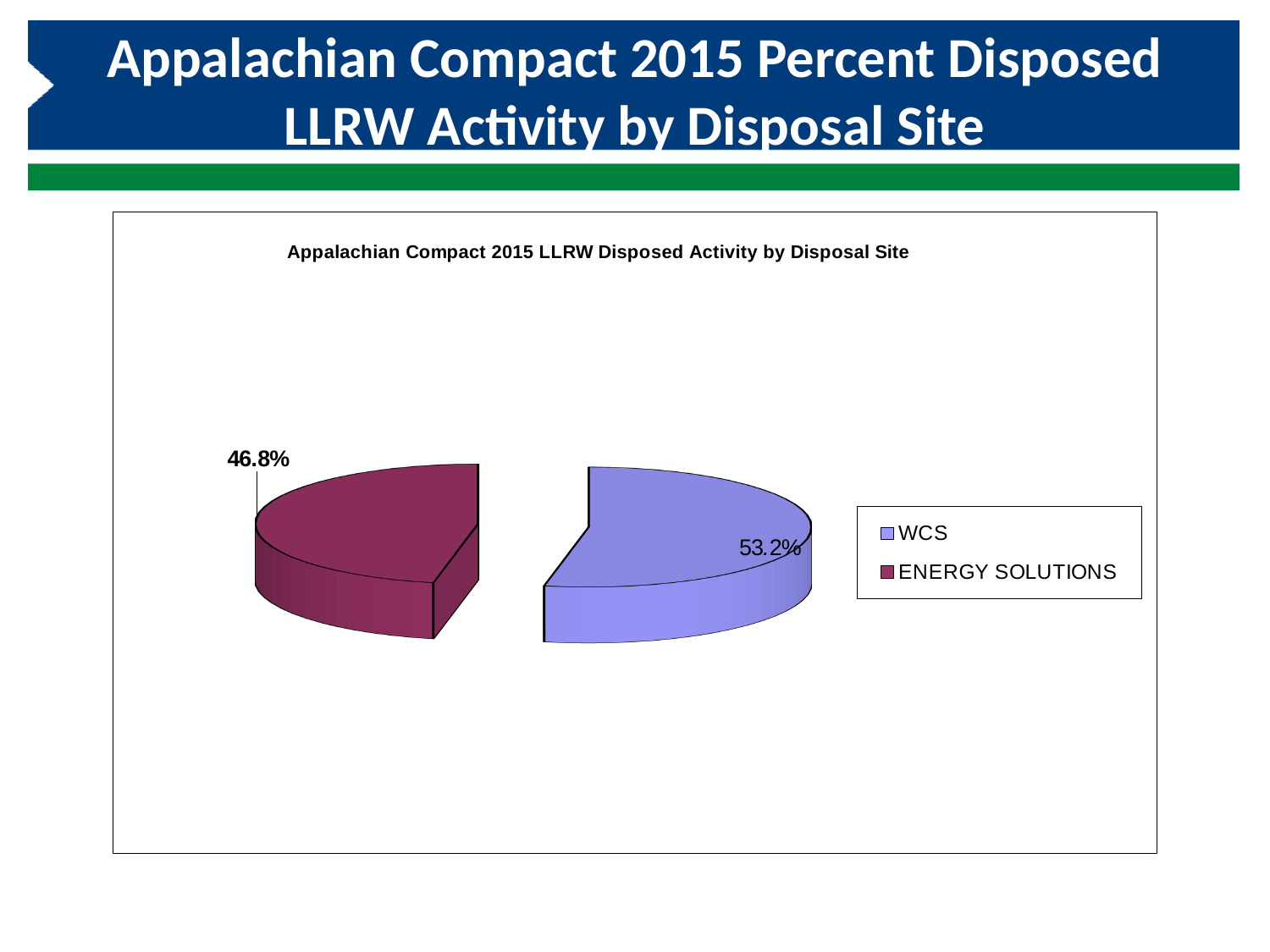
How many slices does the pie chart have? 2 How many entries does the legend list? 2 Which disposal site has the smallest share of the pie? ENERGY SOLUTIONS What is the title of the chart? Appalachian Compact 2015 LLRW Disposed Activity by Disposal Site What share of the pie does ENERGY SOLUTIONS account for? 46.8% What colour is the ENERGY SOLUTIONS slice? Maroon Which disposal site has the largest share of the pie? WCS What kind of chart is shown on the slide? Pie chart What is the difference in percentage points between the WCS share and the ENERGY SOLUTIONS share? 6.4 Which is larger, the share for WCS or the share for ENERGY SOLUTIONS? WCS What share of the pie does WCS account for? 53.2%